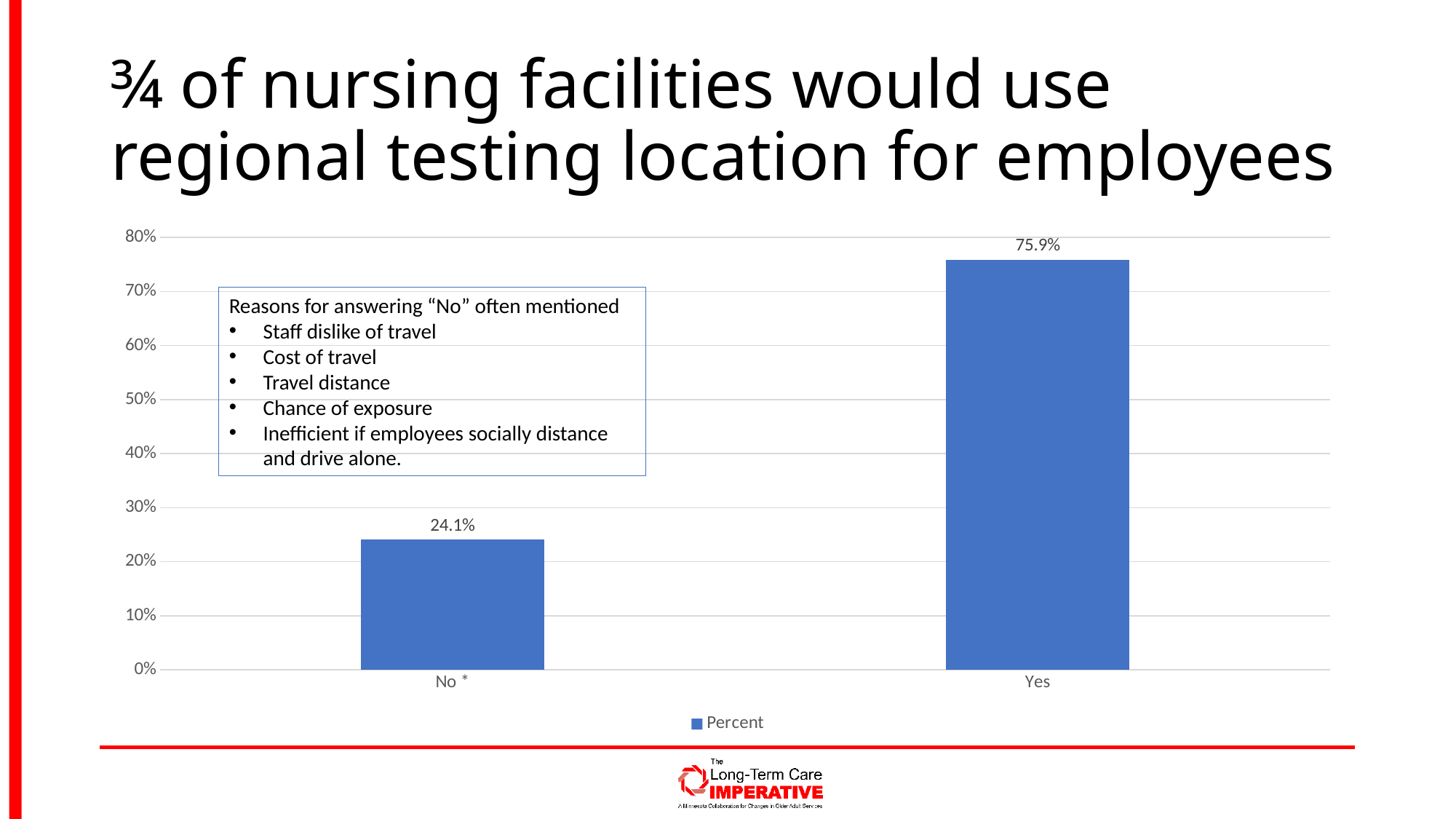
Is the value for Yes greater or less than 70%? greater What is the value for No? 24.1% What kind of chart is shown on the slide? bar chart What is the name of the series shown in the legend? Percent Is the value for No greater or less than 30%? less What is the difference between the values for Yes and No? 51.8% Which is larger, the value for Yes or the value for No? Yes What is the value for Yes? 75.9% How many series does the legend list? 1 Which category has the lowest value? No Which category has the highest value? Yes How many categories are shown on the x axis? 2